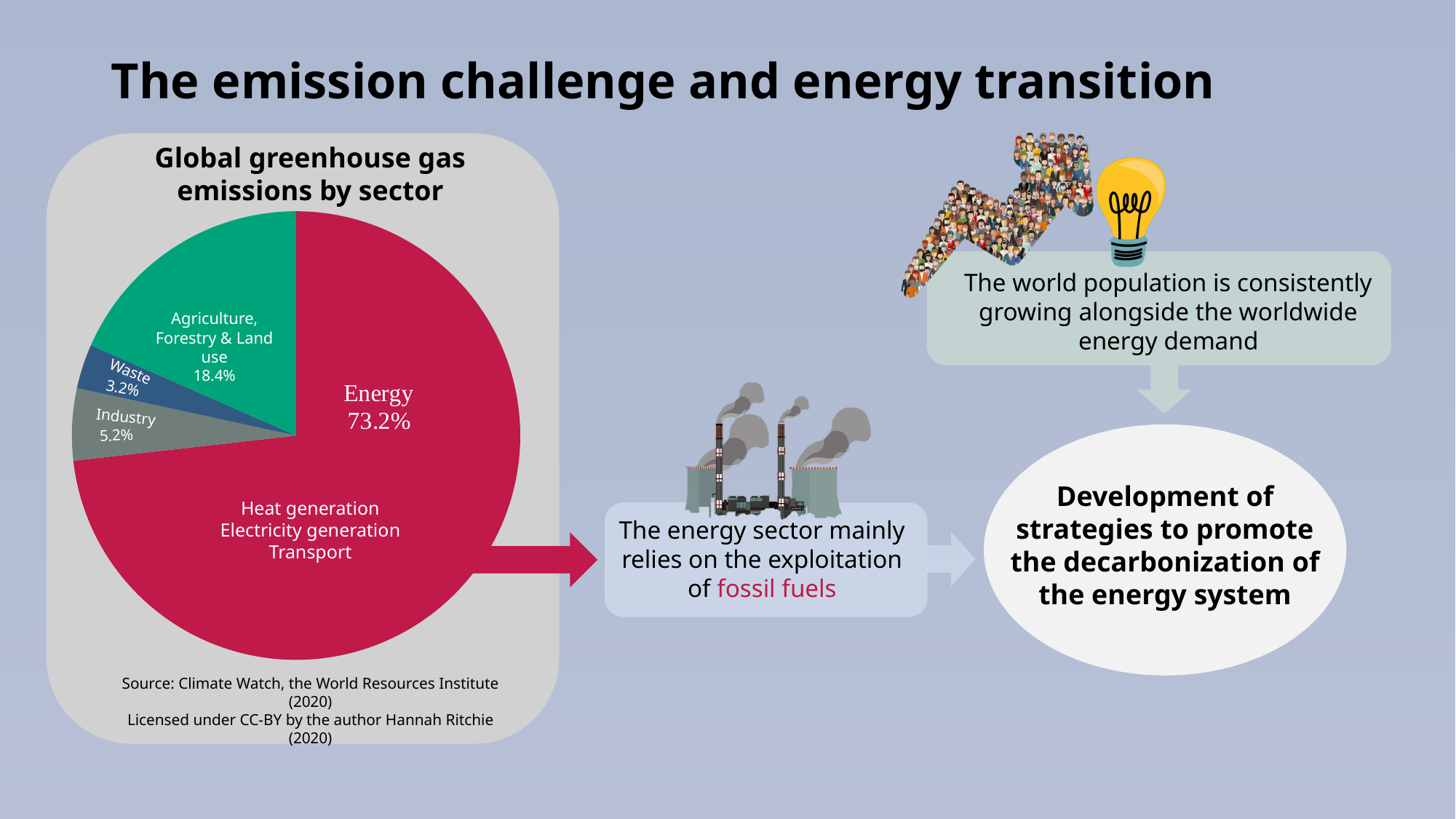
Which sector has the smallest share of global greenhouse gas emissions? Waste How many percentage points larger is the Energy share than the Agriculture, Forestry & Land use share? 54.8 Which sector has the largest share of global greenhouse gas emissions? Energy How many sectors are shown in the pie chart? 4 What share of global greenhouse gas emissions does the Energy sector account for in the pie chart? 73.2% What type of chart is used to show global greenhouse gas emissions by sector? Pie chart What is the value shown for the Waste slice? 3.2% What percentage of emissions is attributed to Agriculture, Forestry & Land use? 18.4% Which is larger, the Industry slice or the Waste slice? Industry What is the value shown for the Industry slice? 5.2% What is the title of the chart on the slide? Global greenhouse gas emissions by sector What is the difference in percentage points between the Industry and Waste slices? 2.0